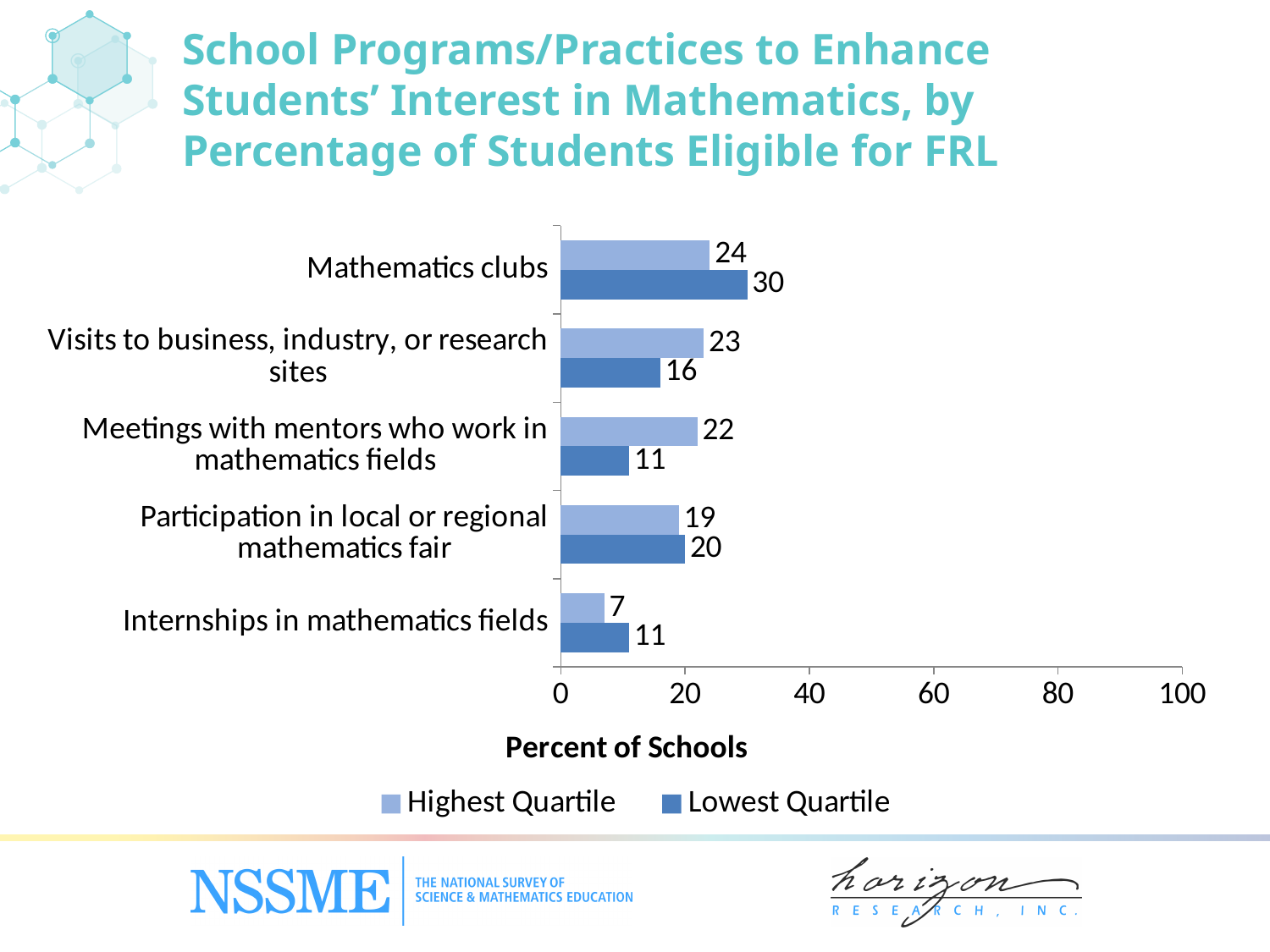
How many series does the legend list? 2 What is the Highest Quartile value for Visits to business, industry, or research sites? 23 Is the Lowest Quartile value for Mathematics clubs greater or less than 20? greater What is the Lowest Quartile value for Mathematics clubs? 30 Which is larger for Visits to business, industry, or research sites: the Highest Quartile value or the Lowest Quartile value? Highest Quartile What is the Highest Quartile value for Internships in mathematics fields? 7 What is the Lowest Quartile value for Meetings with mentors who work in mathematics fields? 11 How many categories are shown on the chart? 5 Which category has the lowest Highest Quartile value? Internships in mathematics fields What kind of chart is shown on the slide? Bar chart What is the difference between the Highest Quartile and Lowest Quartile values for Meetings with mentors who work in mathematics fields? 11 Which category has the highest Lowest Quartile value? Mathematics clubs